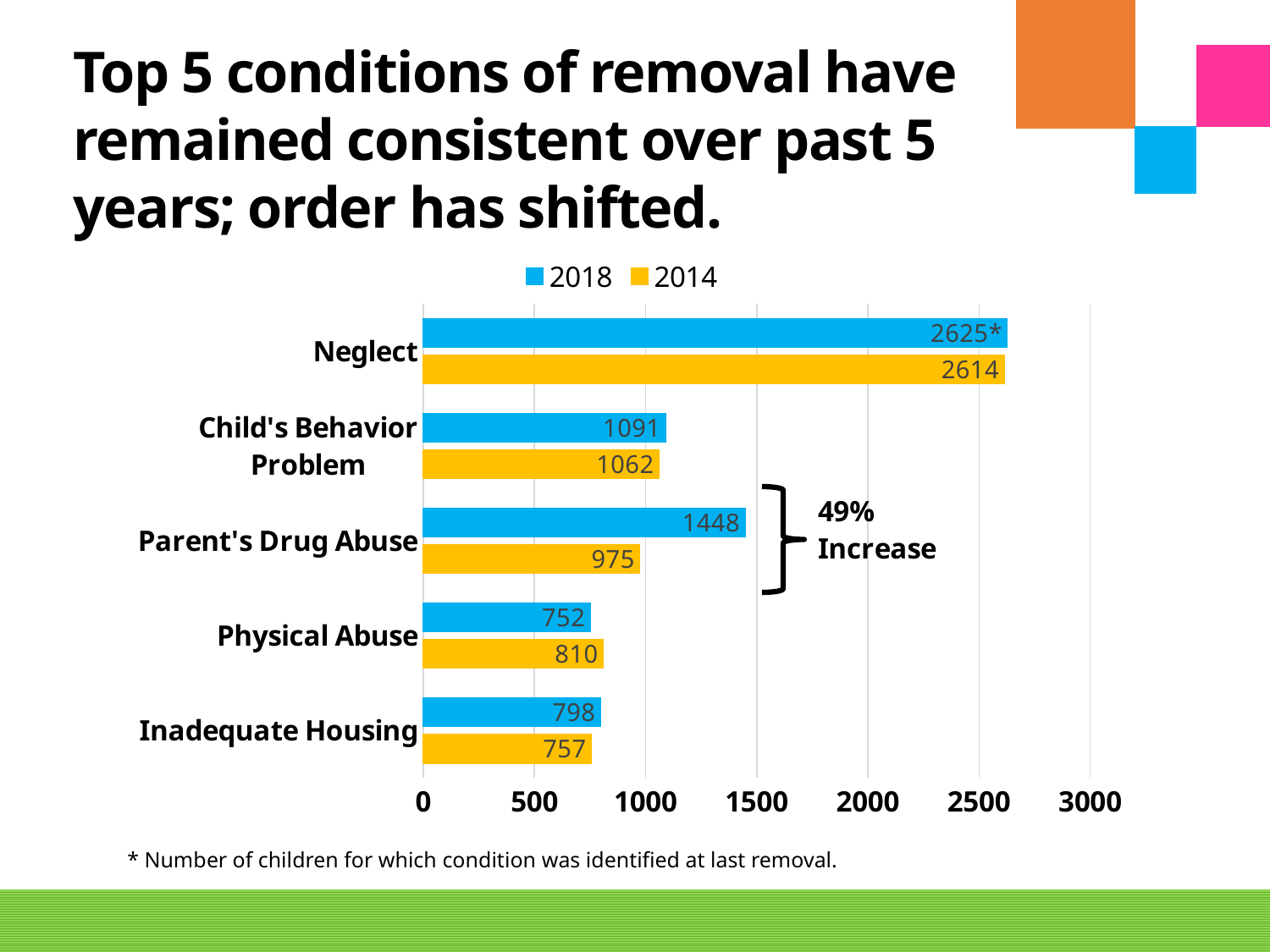
What is the 2018 value for Parent's Drug Abuse? 1448 What kind of chart is shown on the slide? bar chart What is the 2014 value for Physical Abuse? 810 What percentage increase is annotated next to Parent's Drug Abuse? 49% How many conditions are shown on the chart? 5 Which condition has the lowest 2018 value? Physical Abuse How many series does the legend list? 2 What is the difference between the 2018 and 2014 values for Parent's Drug Abuse? 473 Which condition has the highest 2018 value? Neglect Is the 2018 value for Child's Behavior Problem greater or less than 1000? greater Which is larger for Physical Abuse, the 2018 value or the 2014 value? 2014 What is the 2014 value for Child's Behavior Problem? 1062